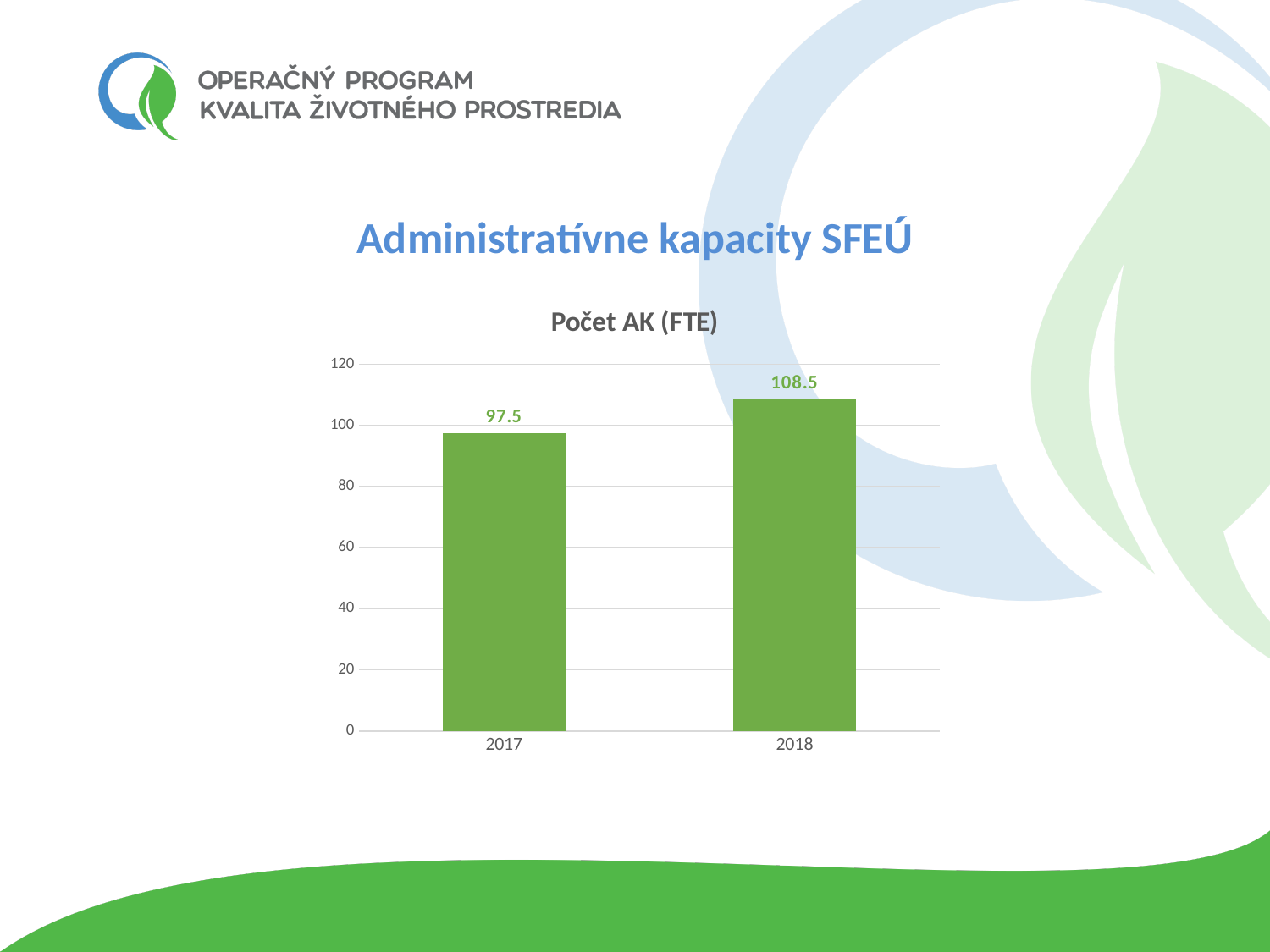
Which is larger, the value for 2017 or the value for 2018? 2018 Is the value for 2018 greater or less than 100? greater What is the value for 2018 in the chart? 108.5 Is the value for 2017 greater or less than 100? less How many categories are shown on the x axis of the chart? 2 Which year has the highest value in the chart? 2018 What is the value for 2017 in the chart? 97.5 What is the difference between the values for 2018 and 2017? 11 Which year has the lowest value in the chart? 2017 What kind of chart is shown on the slide? bar chart Do the values rise or fall from 2017 to 2018? rise What is the title of the chart? Počet AK (FTE)